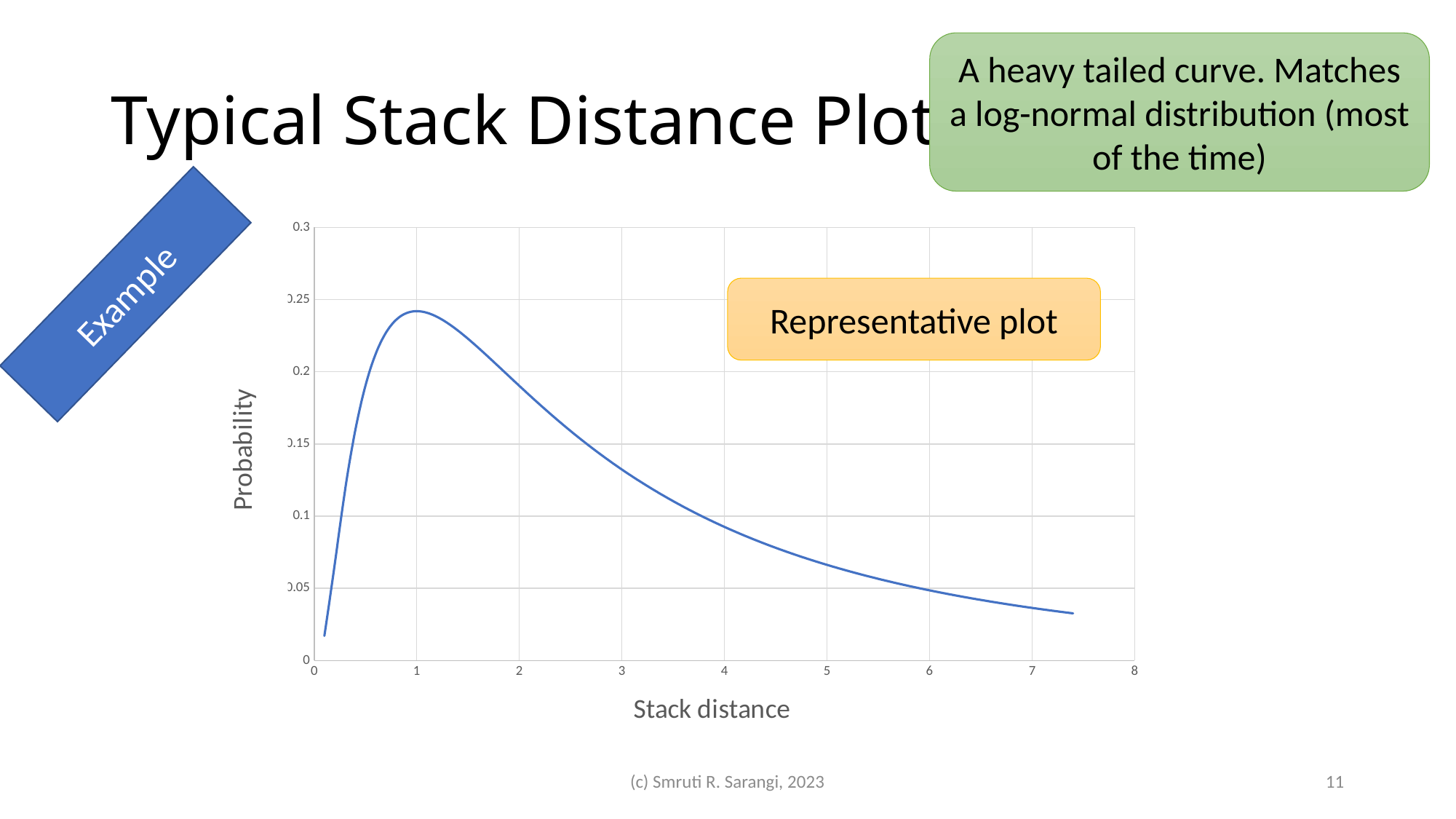
Is the probability at stack distance 5 greater or less than 0.1? less What is the title of the x axis of the chart? Stack distance What kind of chart is shown on the slide? line chart Is the probability at stack distance 3 greater or less than 0.15? less Is the probability at stack distance 7 greater or less than 0.05? less Which has the higher probability: stack distance 1 or stack distance 5? stack distance 1 Does the probability rise or fall as stack distance increases from 2 to 7? fall What is the title of the y axis of the chart? Probability